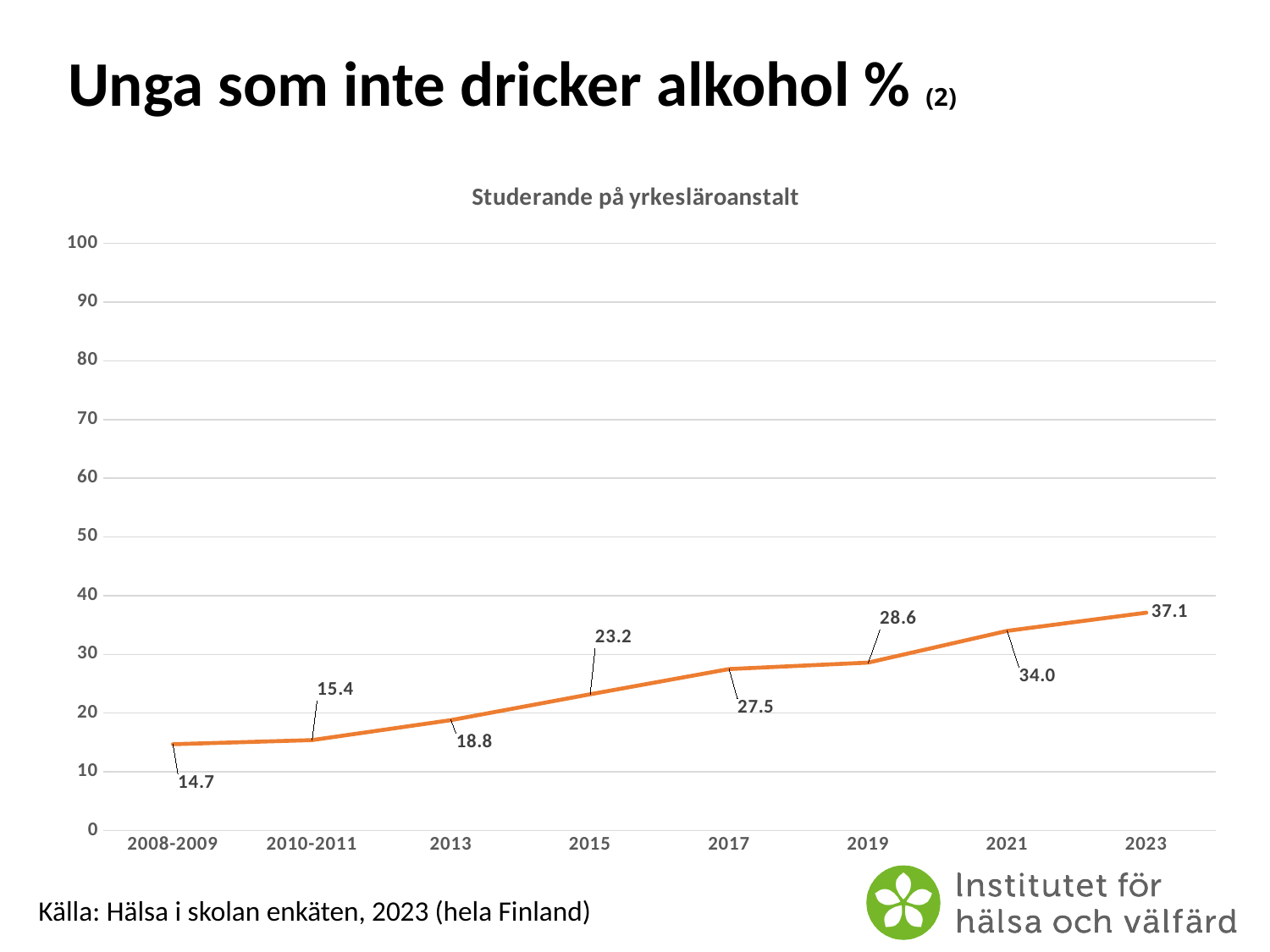
How many data points are plotted on the chart? 8 What is the value for 2019? 28.6 What is the difference between the values for 2021 and 2019? 5.4 Which year has the highest value? 2023 What is the value for 2023? 37.1 What is the value for 2008-2009? 14.7 What kind of chart is shown on the slide? Line chart Do the values rise or fall from 2008-2009 to 2023? Rise Which period has the lowest value? 2008-2009 What is the difference between the values for 2023 and 2008-2009? 22.4 What is the value for 2015? 23.2 Which is larger, the value for 2017 or the value for 2013? 2017